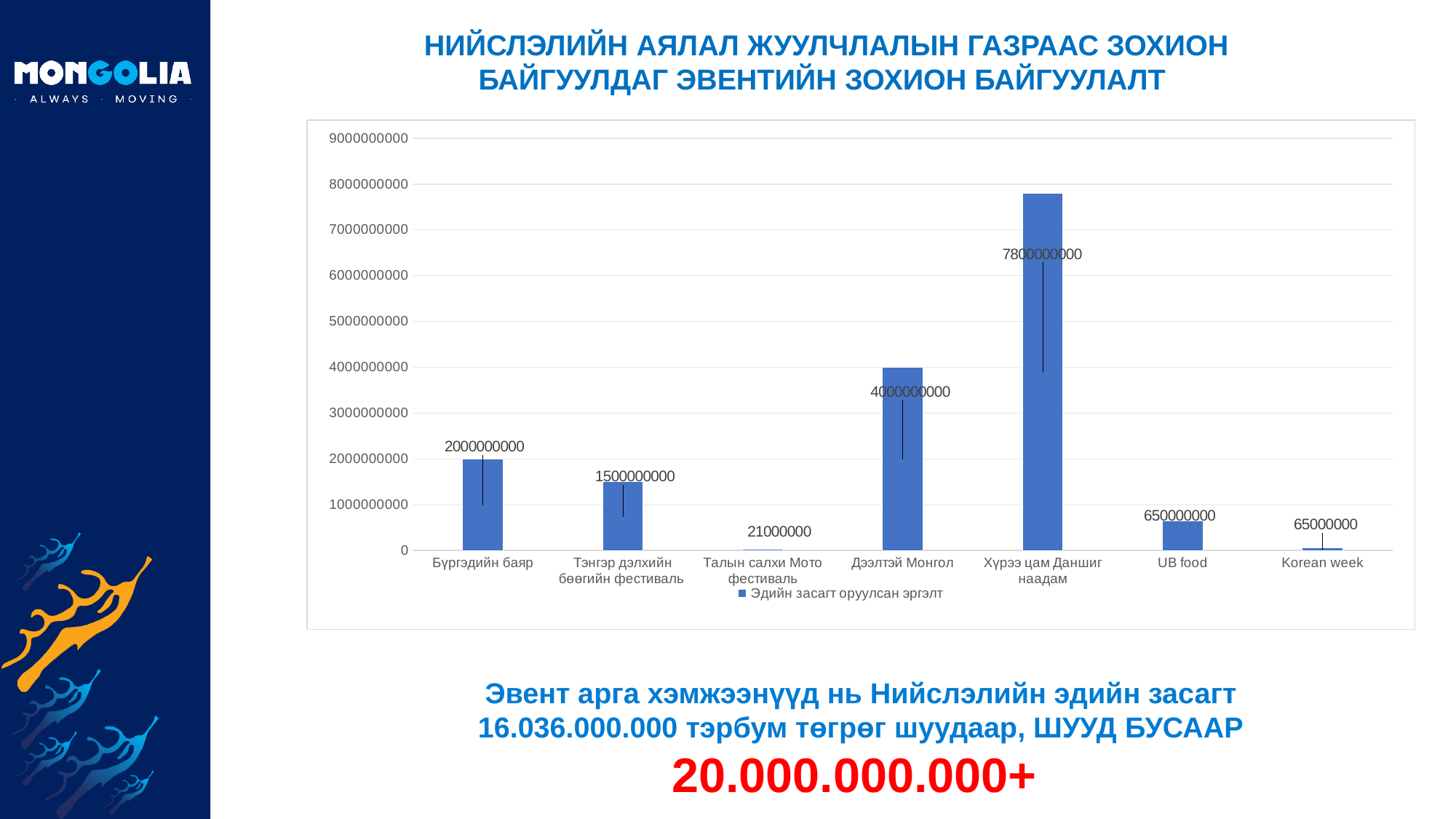
How many series does the chart legend list? 1 What is the name of the series shown in the chart legend? Эдийн засагт оруулсан эргэлт Which category has the lowest value? Талын салхи Мото фестиваль How many categories are plotted on the x axis of the chart? 7 Which is larger, the value for Бүргэдийн баяр or the value for Тэнгэр дэлхийн бөөгийн фестиваль? Бүргэдийн баяр Which category has the highest value? Хүрээ цам Даншиг наадам What is the value for Korean week? 65000000 What is the value for Талын салхи Мото фестиваль? 21000000 What is the value for Хүрээ цам Даншиг наадам? 7800000000 What is the value for Дээлтэй Монгол? 4000000000 What type of chart is shown on the slide? bar chart What is the difference between the values for Хүрээ цам Даншиг наадам and Дээлтэй Монгол? 3800000000